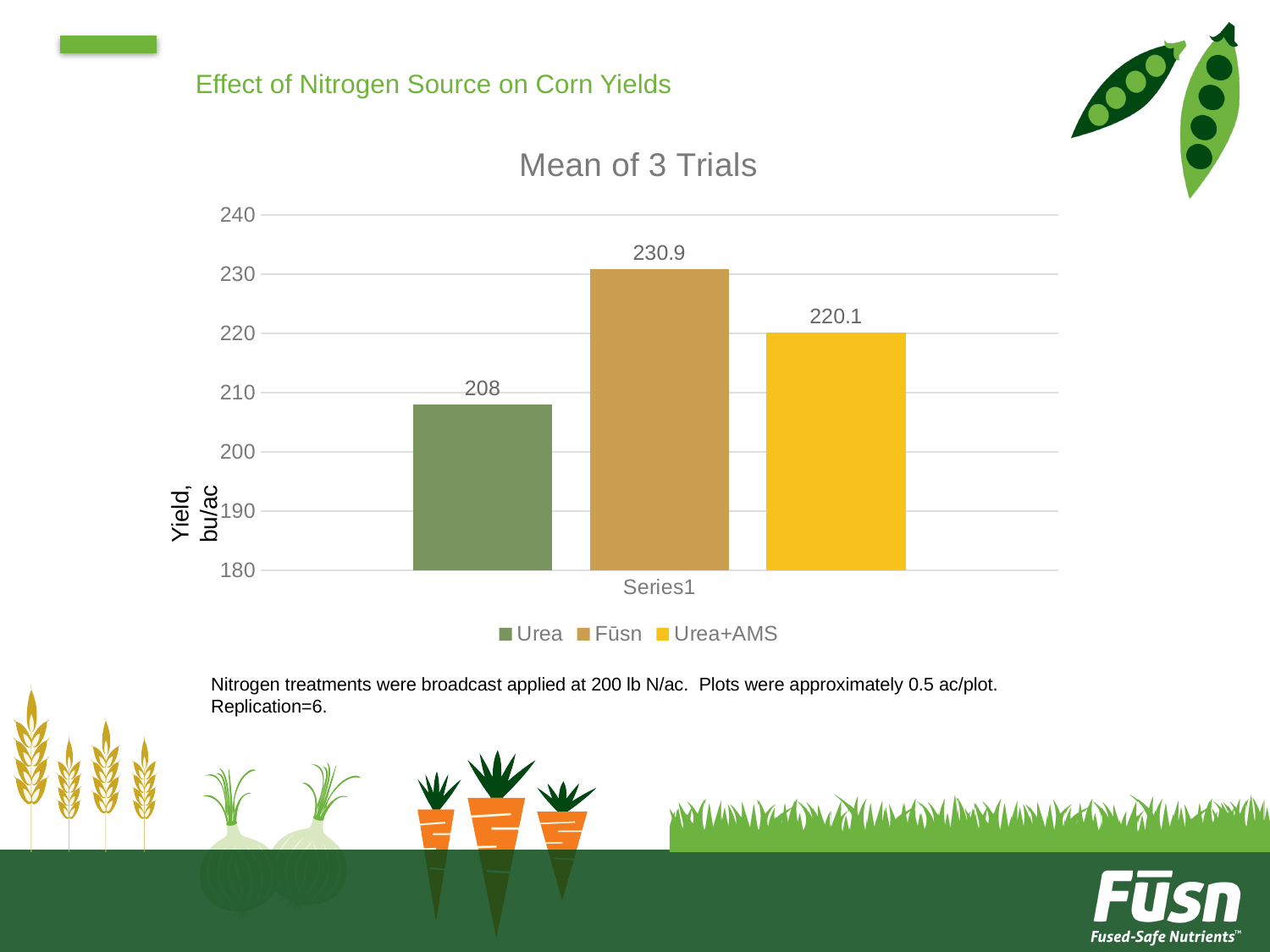
What is the difference in mean yield between Urea+AMS and Urea? 12.1 How many series does the legend list? 3 Is the value for Urea greater or less than 210? less What is the mean corn yield for Urea? 208 Which nitrogen source has the highest mean yield? Fūsn What is the title of the chart? Mean of 3 Trials Which nitrogen source has the lowest mean yield? Urea What kind of chart is shown on the slide? Bar chart Which has a higher mean yield, Urea+AMS or Fūsn? Fūsn What is the mean corn yield for Fūsn? 230.9 What is the difference in mean yield between Fūsn and Urea? 22.9 What is the mean corn yield for Urea+AMS? 220.1